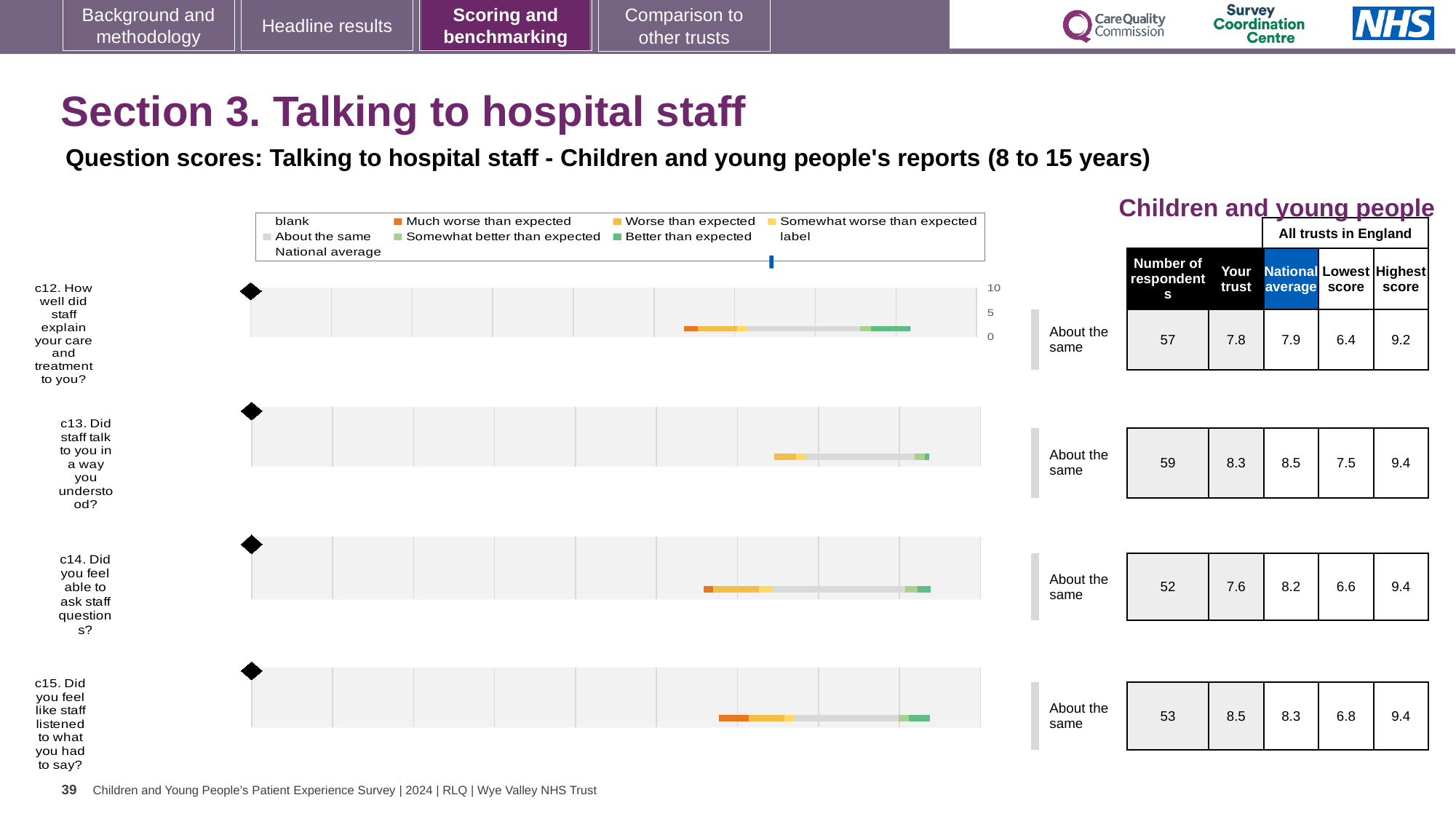
Which question (c12 to c15) has the lowest 'Your trust' score? c14 For the c13 chart (Did staff talk to you in a way you understood?), what is the national average score shown in the table? 8.5 For the c15 chart, which is larger: the 'Your trust' score or the national average? Your trust What kind of chart is used to show the benchmark results for question c12? bar chart For the c15 chart (Did you feel like staff listened to what you had to say?), what is the highest score across all trusts in England? 9.4 How many entries does the shared legend above the charts list? 9 For the c12 chart (How well did staff explain your care and treatment to you?), what is the 'Your trust' score shown in the table? 7.8 How many question charts (c12 to c15) are shown on the slide? 4 Which question (c12 to c15) has the highest 'Your trust' score? c15 What benchmark category label is shown next to the c13 chart? About the same For the c14 chart (Did you feel able to ask staff questions?), how many respondents are shown in the table? 52 For the c14 chart, what is the difference between the national average and the 'Your trust' score? 0.6